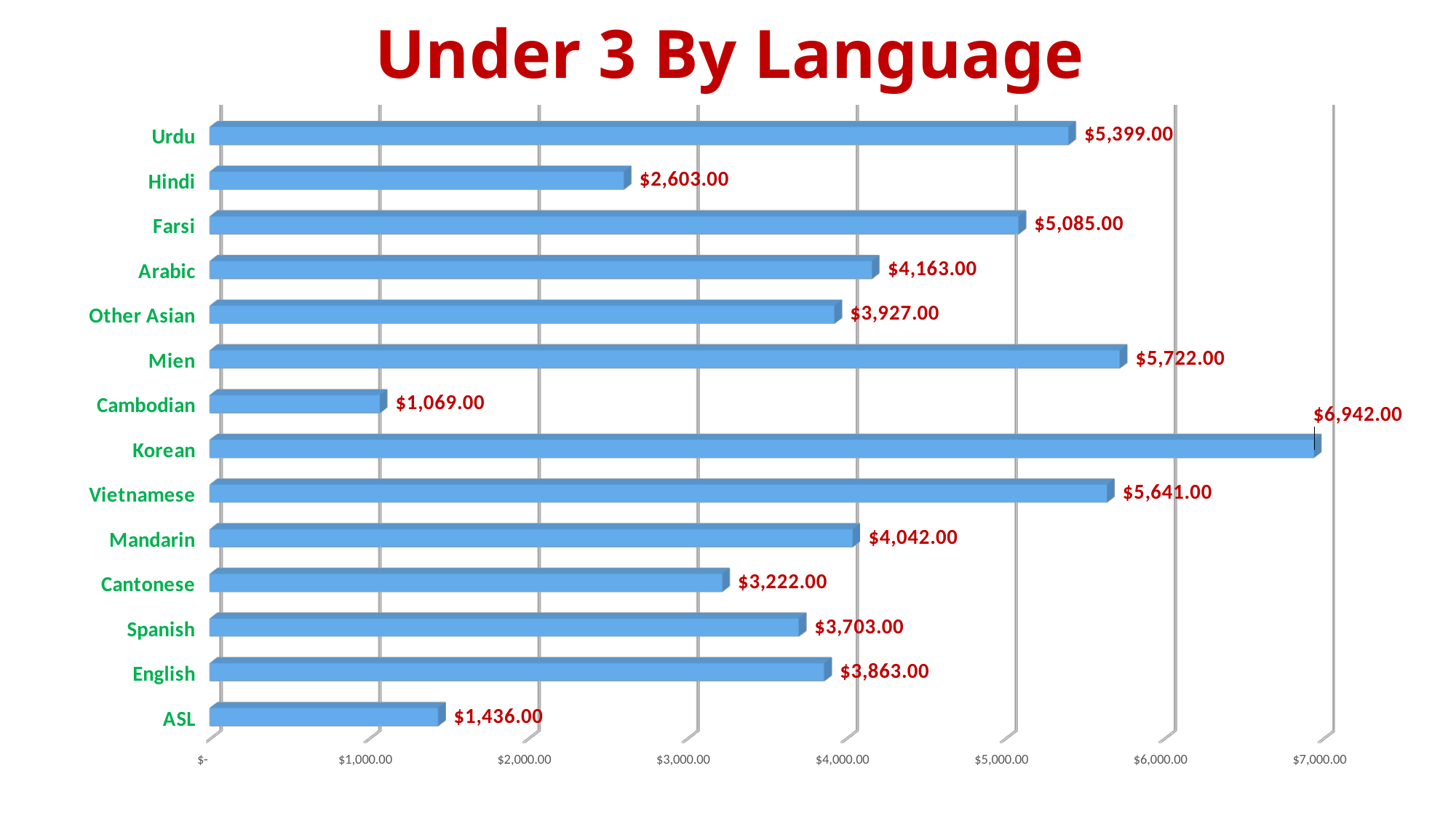
What is the difference between the values for Urdu and Hindi? $2,796.00 Which language has the lowest value? Cambodian How many languages are shown in the chart? 14 Which language has the highest value? Korean What is the value for Spanish? $3,703.00 Is the value for English greater or less than $4,000.00? less What is the value for Korean? $6,942.00 Which is larger, the value for Farsi or the value for Arabic? Farsi What kind of chart is shown on the slide? Bar chart What is the title of the chart? Under 3 By Language What is the value for Cambodian? $1,069.00 What is the difference between the values for Mien and Vietnamese? $81.00